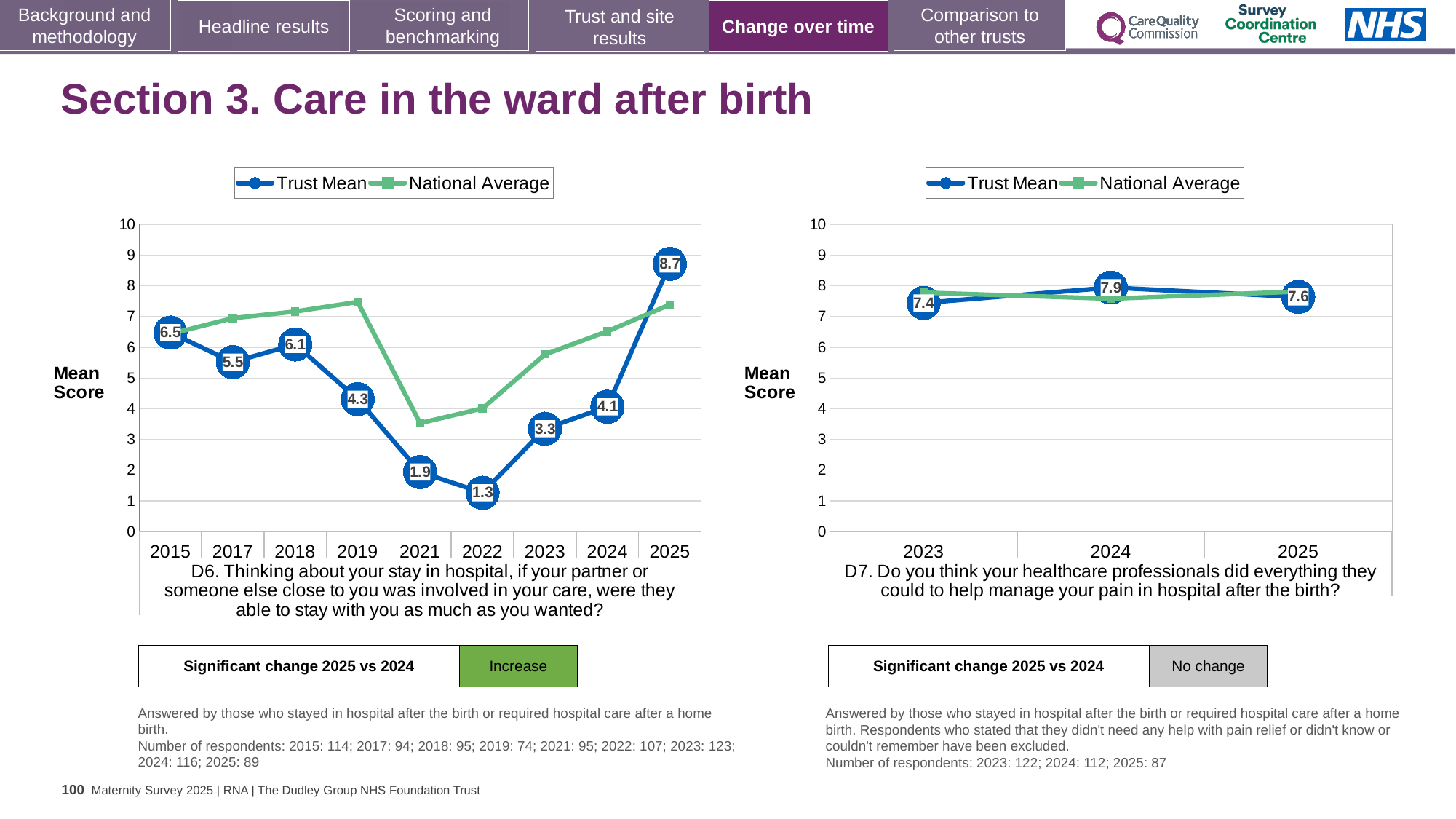
What kind of chart is the left chart (D6)? line chart In the left chart (D6), what is the Trust Mean for 2022? 1.3 In the right chart (D7), is the Trust Mean for 2023 larger or smaller than the Trust Mean for 2025? smaller In the left chart (D6), how many years are shown on the x axis? 9 In the right chart (D7), what is the Trust Mean for 2024? 7.9 In the left chart (D6), which year has the highest Trust Mean? 2025 In the left chart (D6), which year has the lowest Trust Mean? 2022 In the left chart (D6), what is the difference between the Trust Mean for 2025 and 2024? 4.6 How many series does the legend of the right chart (D7) list? 2 In the right chart (D7), which year has the highest Trust Mean? 2024 In the left chart (D6), is the National Average for 2021 greater or less than 4? less In the left chart (D6), what is the Trust Mean for 2025? 8.7